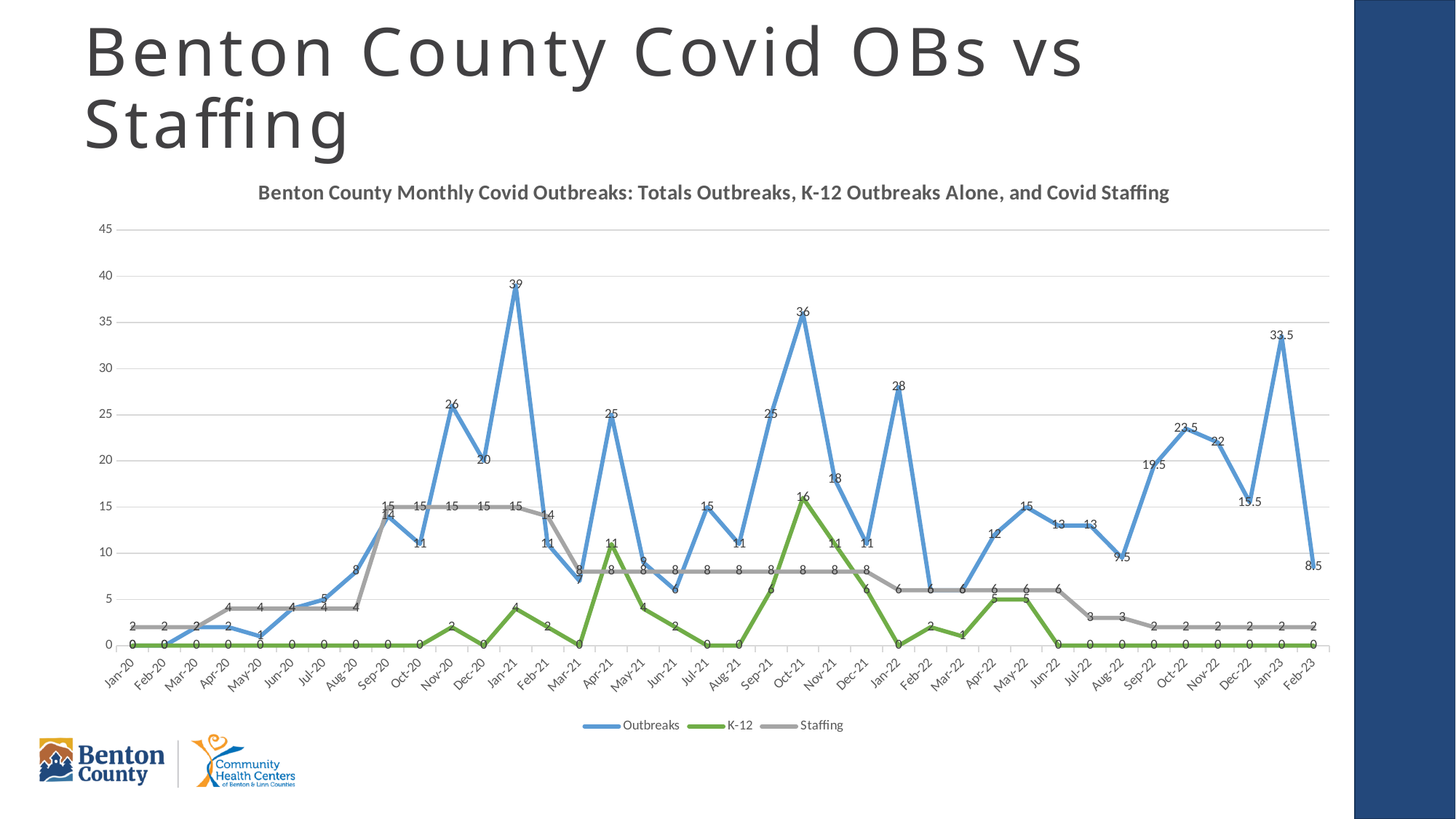
What was the K-12 value in Oct-21? 16 What type of chart is shown on the slide? Line chart Which is larger, the Outbreaks value in Nov-20 or in Dec-20? Nov-20 What was the Outbreaks value in Jan-23? 33.5 What was the Outbreaks value in Oct-21? 36 What was the Outbreaks value in Jan-21? 39 What is the title of the chart? Benton County Monthly Covid Outbreaks: Totals Outbreaks, K-12 Outbreaks Alone, and Covid Staffing How many series does the legend list? 3 In which month did K-12 outbreaks reach their highest value? Oct-21 In which month did Outbreaks reach its highest value? Jan-21 What is the difference between the Outbreaks value in Jan-21 (39) and in Oct-21 (36)? 3 What was the Staffing value in Nov-20? 15